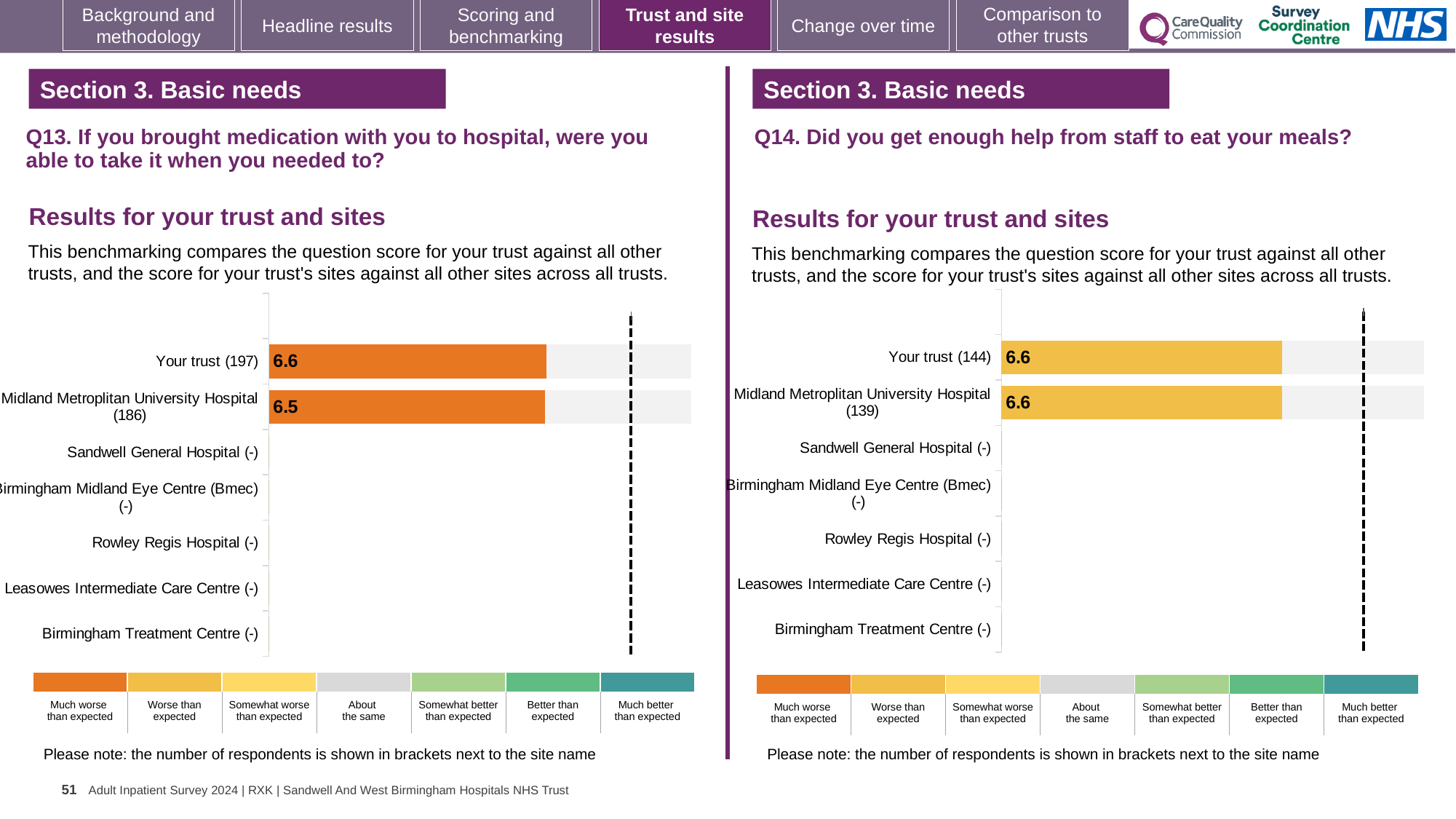
On the Q14 chart (right), which benchmark category does the colour of the bars correspond to in the legend? Worse than expected On the Q13 chart (left), what is the score for Your trust? 6.6 On the Q13 chart (left), which benchmark category does the colour of the bars correspond to in the legend? Much worse than expected On the Q13 chart (left), what is the score for Midland Metroplitan University Hospital? 6.5 On the Q13 chart (left), what is the difference between the score for Your trust and the score for Midland Metroplitan University Hospital? 0.1 How many site or trust categories are listed on the Q13 chart (left)? 7 On the Q13 chart (left), which has the higher score: Your trust or Midland Metroplitan University Hospital? Your trust On the Q14 chart (right), what is the score for Midland Metroplitan University Hospital? 6.6 What kind of chart is the Q14 chart (right)? Bar chart On the Q14 chart (right), how many respondents are shown in brackets for Midland Metroplitan University Hospital? 139 On the Q13 chart (left), how many respondents are shown in brackets for Your trust? 197 On the Q14 chart (right), what is the score for Your trust? 6.6